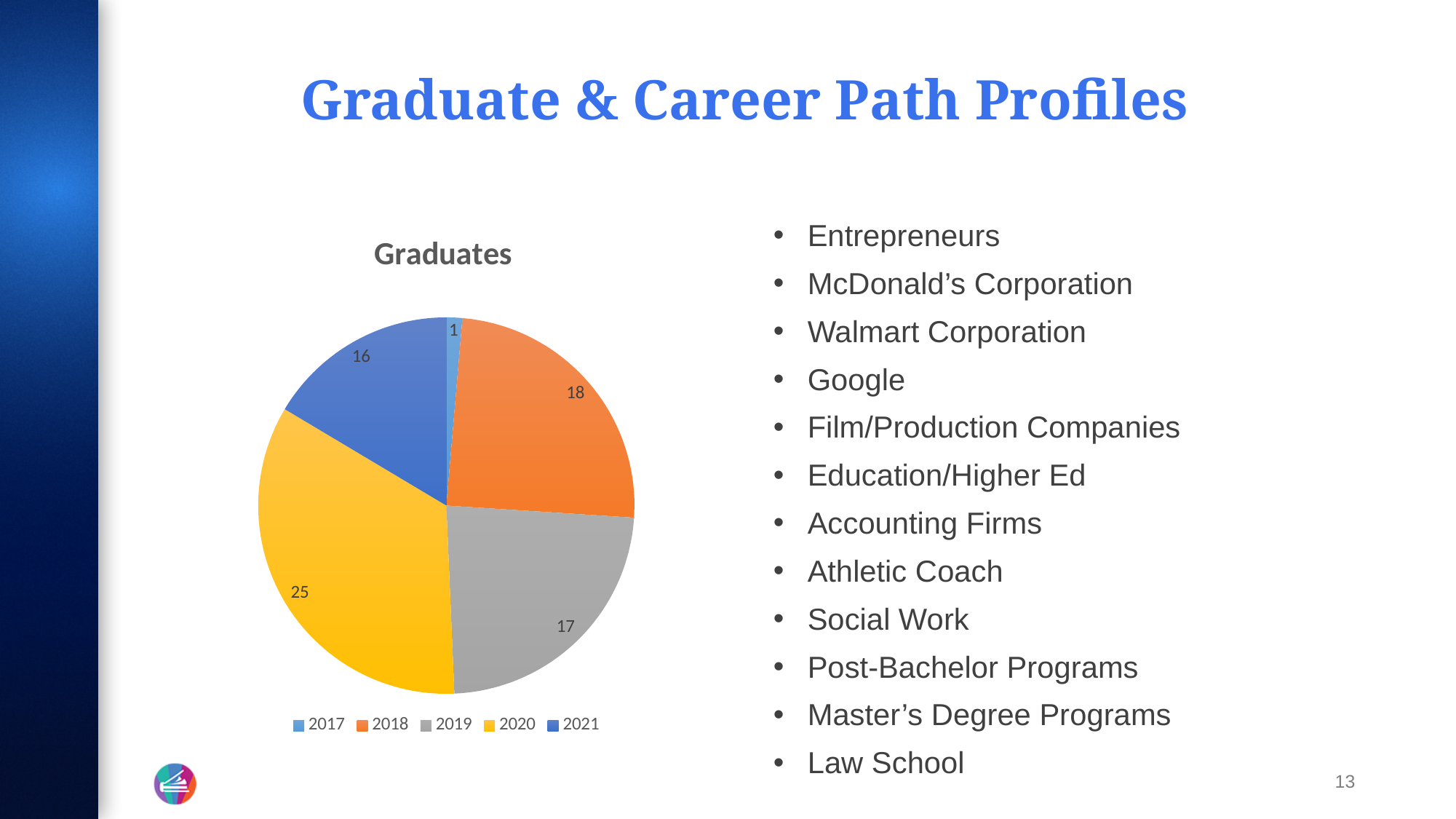
What is the title of the pie chart? Graduates Which year has the smallest slice in the Graduates pie chart? 2017 What is the value for 2017 in the Graduates pie chart? 1 What is the value for 2019 in the Graduates pie chart? 17 What is the difference between the 2020 and 2021 values in the Graduates pie chart? 9 Which years are listed in the legend of the Graduates pie chart? 2017, 2018, 2019, 2020, 2021 What type of chart is shown on the slide? pie chart How many years (slices) are shown in the Graduates pie chart? 5 What is the total of all slices in the Graduates pie chart? 77 Which year has a larger value in the Graduates pie chart, 2018 or 2019? 2018 Which year has the largest slice in the Graduates pie chart? 2020 How many graduates are shown for 2020 in the Graduates pie chart? 25